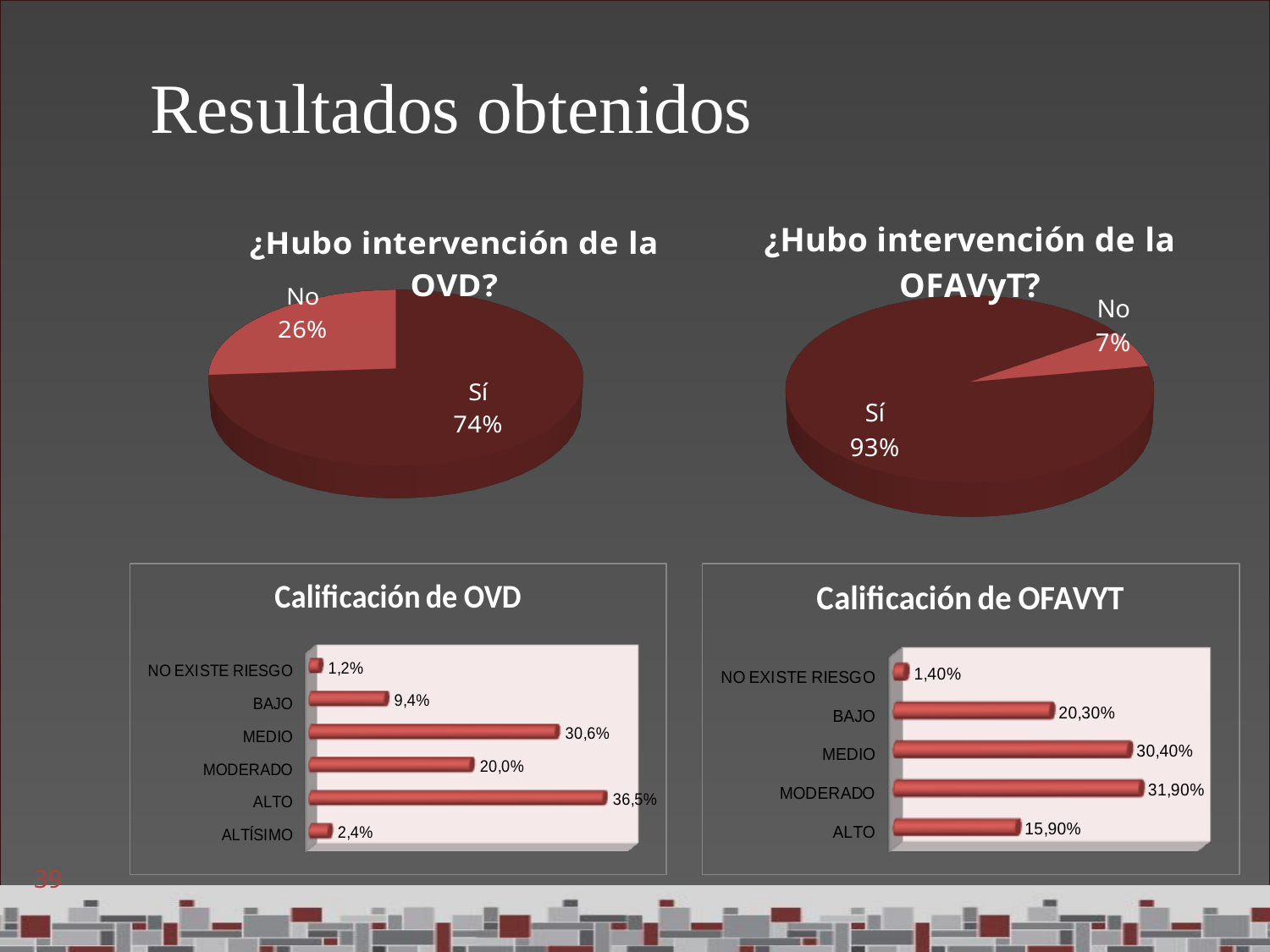
In the 'Calificación de OFAVYT' chart, which category has the highest value? MODERADO In the 'Calificación de OFAVYT' chart, which is larger, MEDIO or BAJO? MEDIO In the 'Calificación de OVD' chart, which category has the highest value? ALTO In the 'Calificación de OVD' chart, what is the value for MEDIO? 30,6% In the 'Calificación de OVD' chart, how many categories are shown? 6 In the '¿Hubo intervención de la OVD?' pie chart, what share is labelled 'Sí'? 74% What kind of chart is '¿Hubo intervención de la OVD?'? Pie chart In the 'Calificación de OVD' chart, which category has the lowest value? NO EXISTE RIESGO In the 'Calificación de OFAVYT' chart, what is the difference between MODERADO and ALTO? 16,00% What kind of chart is 'Calificación de OFAVYT'? Bar chart In the '¿Hubo intervención de la OFAVyT?' pie chart, what share is labelled 'No'? 7% In the 'Calificación de OFAVYT' chart, what is the value for BAJO? 20,30%